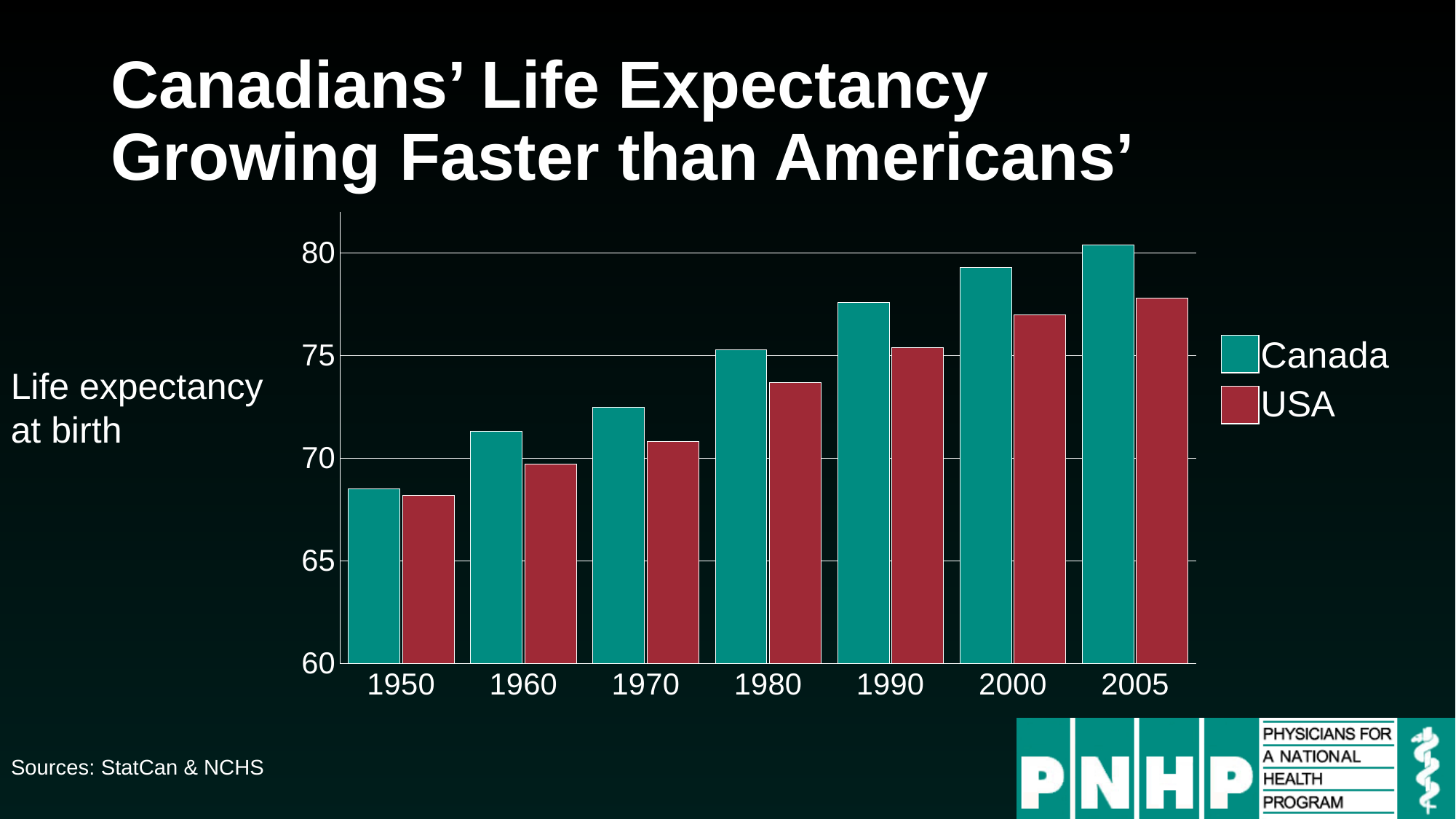
Is the value for USA in 2005 greater or less than 80? less How many years are shown along the x axis? 7 Which colour represents USA in the legend? red Is the value for Canada in 1990 greater or less than 75? greater What kind of chart is shown on the slide? bar chart Is the value for Canada in 1950 greater or less than 70? less How many series does the legend list? 2 In 1990, which is larger, the Canada value or the USA value? Canada Which year has the lowest USA bar? 1950 Which year has the highest Canada bar? 2005 Do the Canada values rise or fall from 1950 to 2005? rise